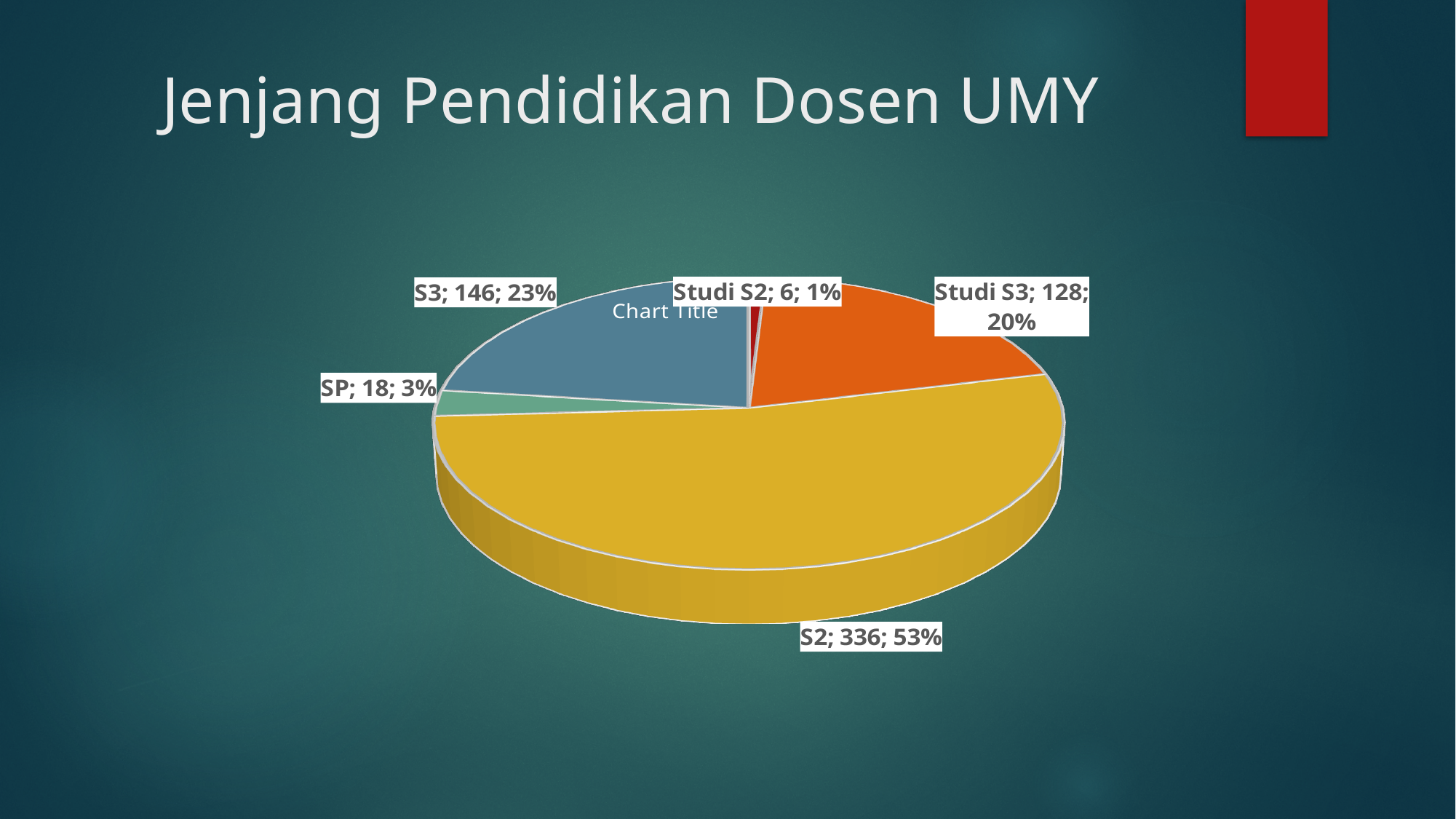
What is the value for Studi S3? 128 What is the value for Studi S2? 6 How many categories are shown in the pie chart? 5 What is the value for S3? 146 What share of the pie does S3 represent? 23% What is the value for S2? 336 What is the value for SP? 18 Which category has the smallest slice? Studi S2 What is the difference between the values for S2 and S3? 190 Which category has the largest slice? S2 What kind of chart is shown on the slide? pie chart What share of the pie does Studi S3 represent? 20%